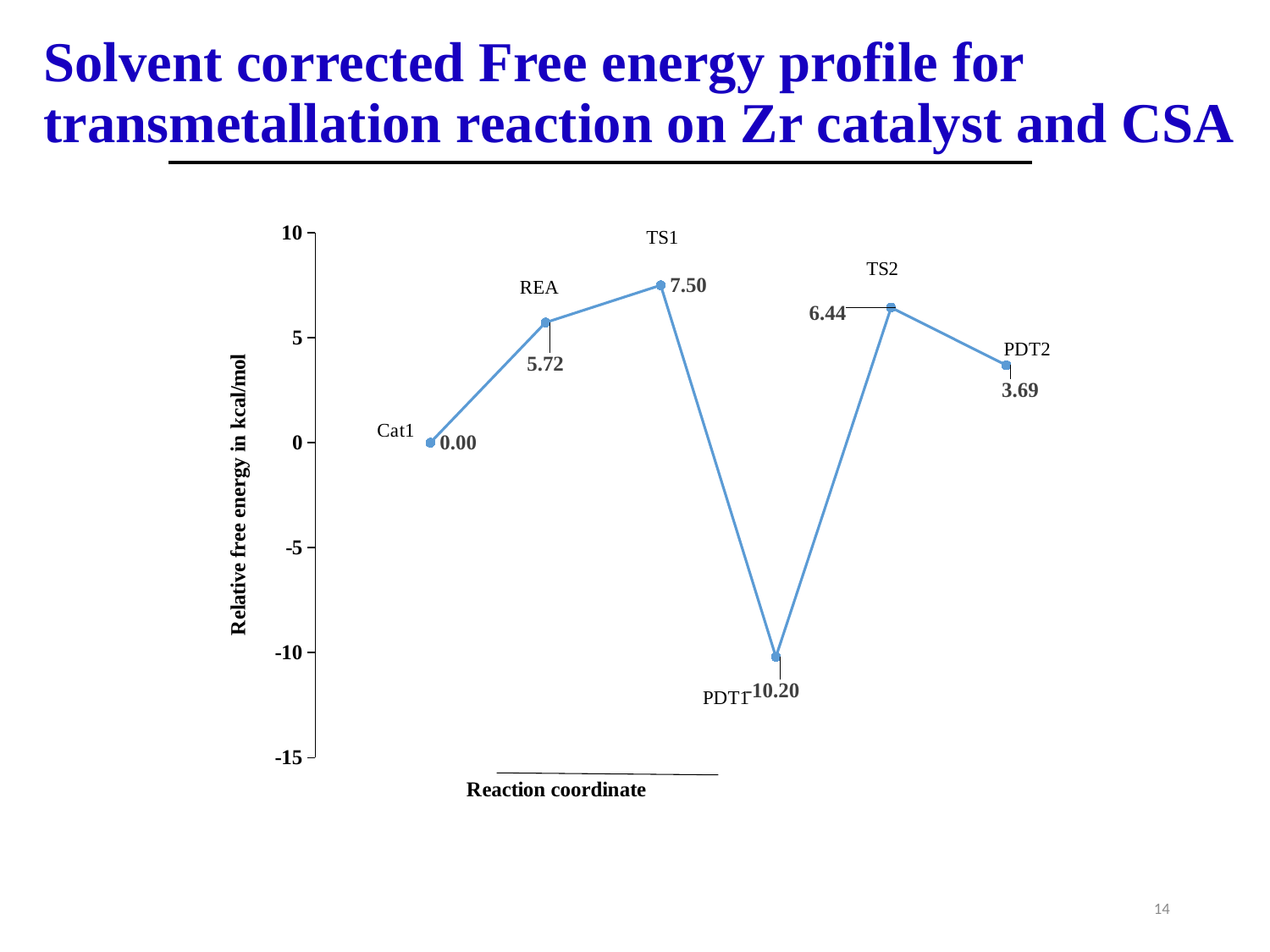
What kind of chart is shown on the slide? line chart Which point on the reaction coordinate has the lowest relative free energy? PDT1 What is the relative free energy value for PDT2? 3.69 Which has a higher relative free energy, TS2 or PDT2? TS2 What is the difference in relative free energy between TS1 and REA? 1.78 What is the difference in relative free energy between TS2 and PDT2? 2.75 How many points are plotted along the reaction coordinate? 6 What is the relative free energy value for TS1? 7.50 What is the relative free energy value for REA? 5.72 Which point on the reaction coordinate has the highest relative free energy? TS1 What is the relative free energy value for TS2? 6.44 Is the value for PDT1 greater or less than -5? less